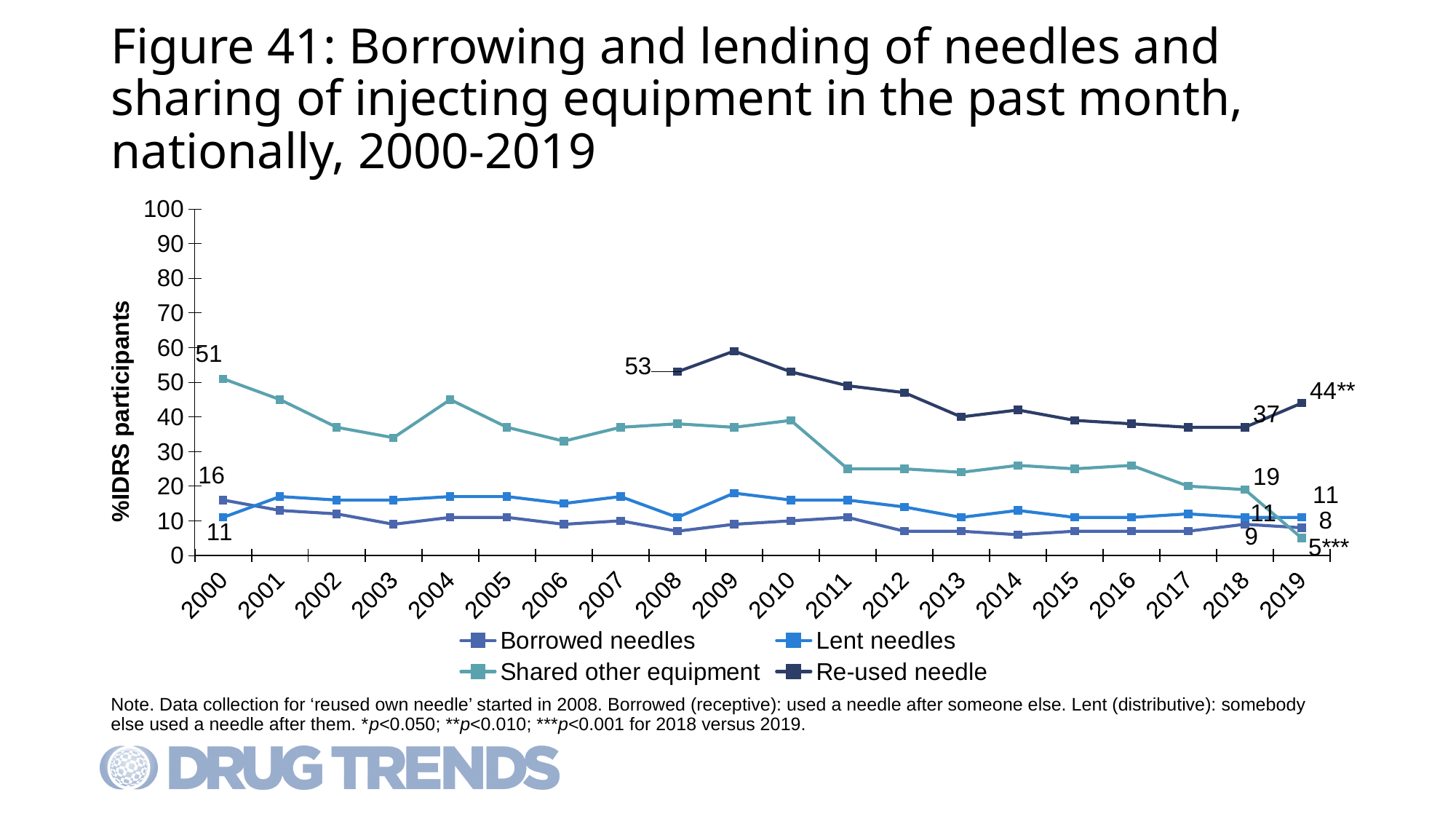
Is the value for Re-used needle in 2009 greater or less than 50? greater How many years are shown on the x axis? 20 How many series does the legend list? 4 Does the Shared other equipment series rise or fall from 2000 to 2019? fall In 2019, which is larger: Lent needles or Borrowed needles? Lent needles What is the value for Borrowed needles in 2000? 16 What is the value for Re-used needle in 2008? 53 What kind of chart is shown on the slide? line chart What is the value for Shared other equipment in 2019? 5 What is the value for Shared other equipment in 2000? 51 What is the difference between the Shared other equipment values in 2018 and 2019? 14 What is the difference between the Re-used needle values in 2019 and 2018? 7